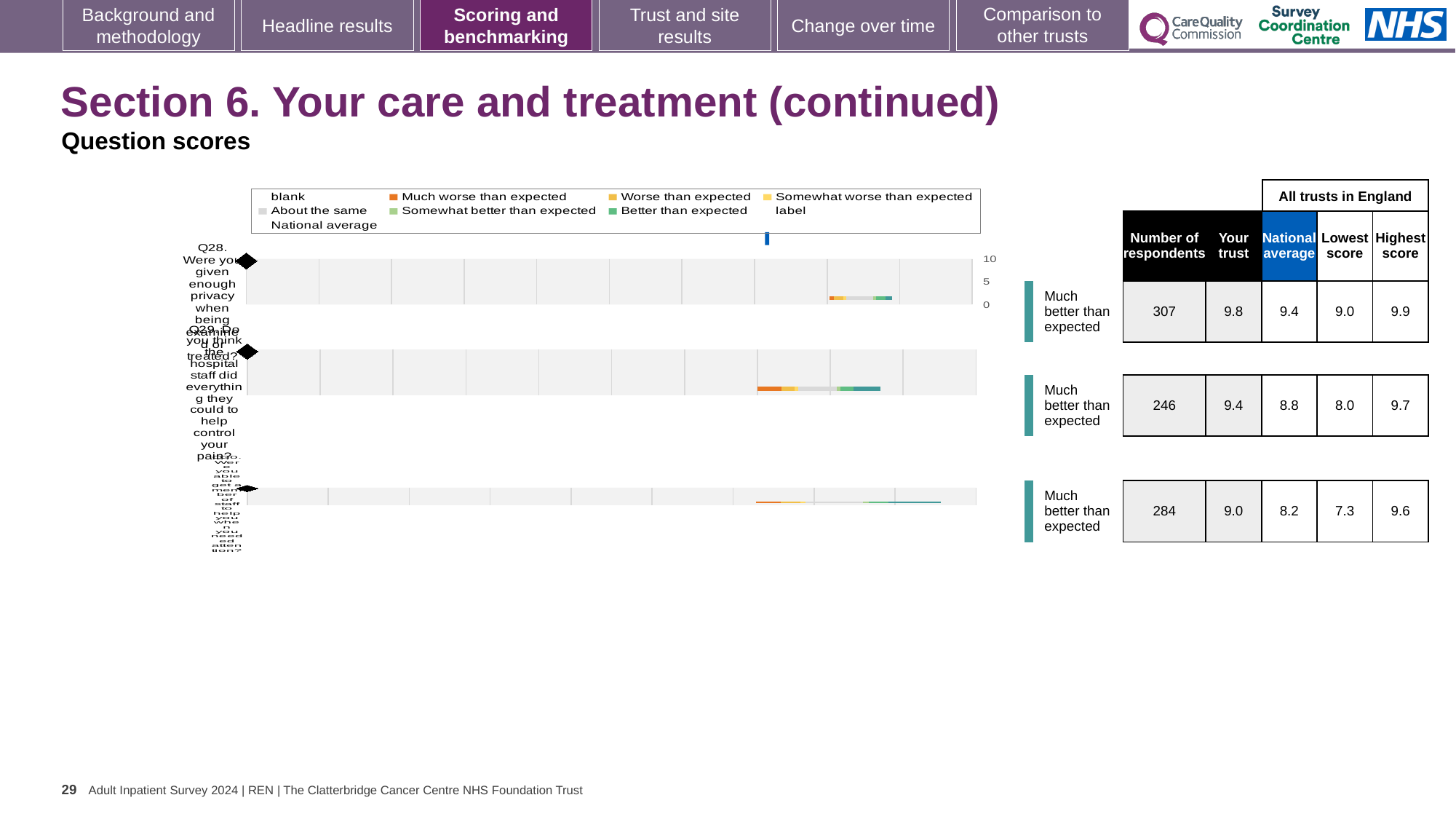
What is the difference between the 'Your trust' score and the national average for Q28? 0.4 What is the 'Your trust' score for Q28 (privacy when being examined or treated)? 9.8 How many questions are plotted on this slide? 3 Which of the three questions has the highest 'Your trust' score? Q28 What is the maximum value shown on the score axis of the charts? 10 How many respondents answered the third question (Q30)? 284 Which of the three questions has the lowest 'Lowest score' across all trusts in England? Q30 For Q29, which is larger: the 'Your trust' score or the national average? Your trust What kind of chart is used to show the question scores? Bar chart What is the national average score for Q29 (hospital staff helping control pain)? 8.8 What is the highest score among all trusts in England for Q28? 9.9 What benchmark category is shown next to the Q29 chart? Much better than expected